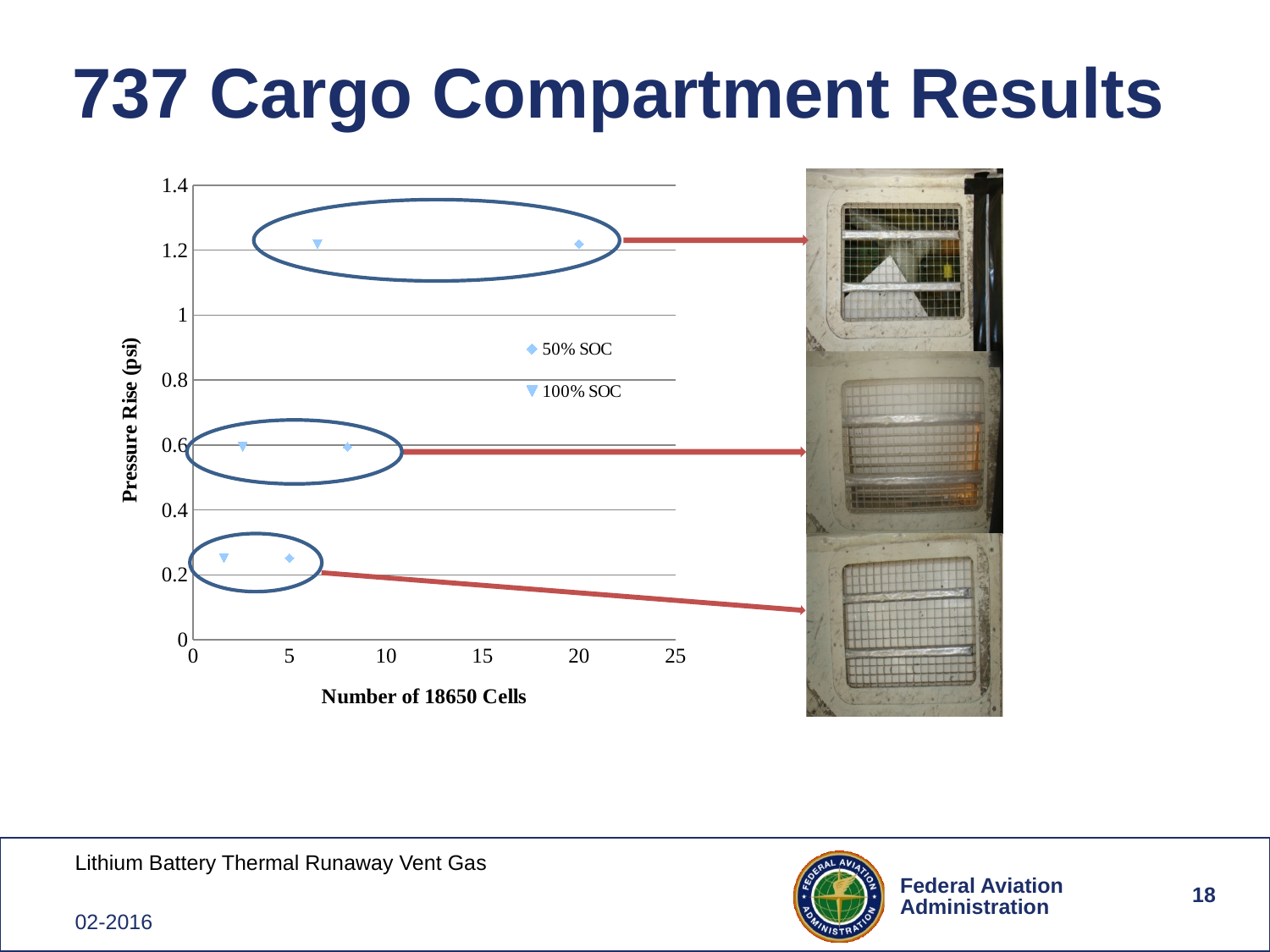
What are the two series named in the legend? 50% SOC and 100% SOC Is the pressure rise for the 50% SOC point at 20 cells greater or less than 1 psi? greater What is the title of the y axis? Pressure Rise (psi) Is the pressure rise for the 50% SOC point at 5 cells greater or less than 0.4 psi? less Is the pressure rise for the 100% SOC point at about 6 cells greater or less than 1 psi? greater How many data points are plotted in total on the chart? 6 Does the pressure rise increase or decrease as the number of 18650 cells increases? increase How many series does the chart legend list? 2 Which series reaches a pressure rise above 1 psi with fewer cells, 50% SOC or 100% SOC? 100% SOC What kind of chart is shown on the slide? scatter chart How many data points are plotted for the 50% SOC series? 3